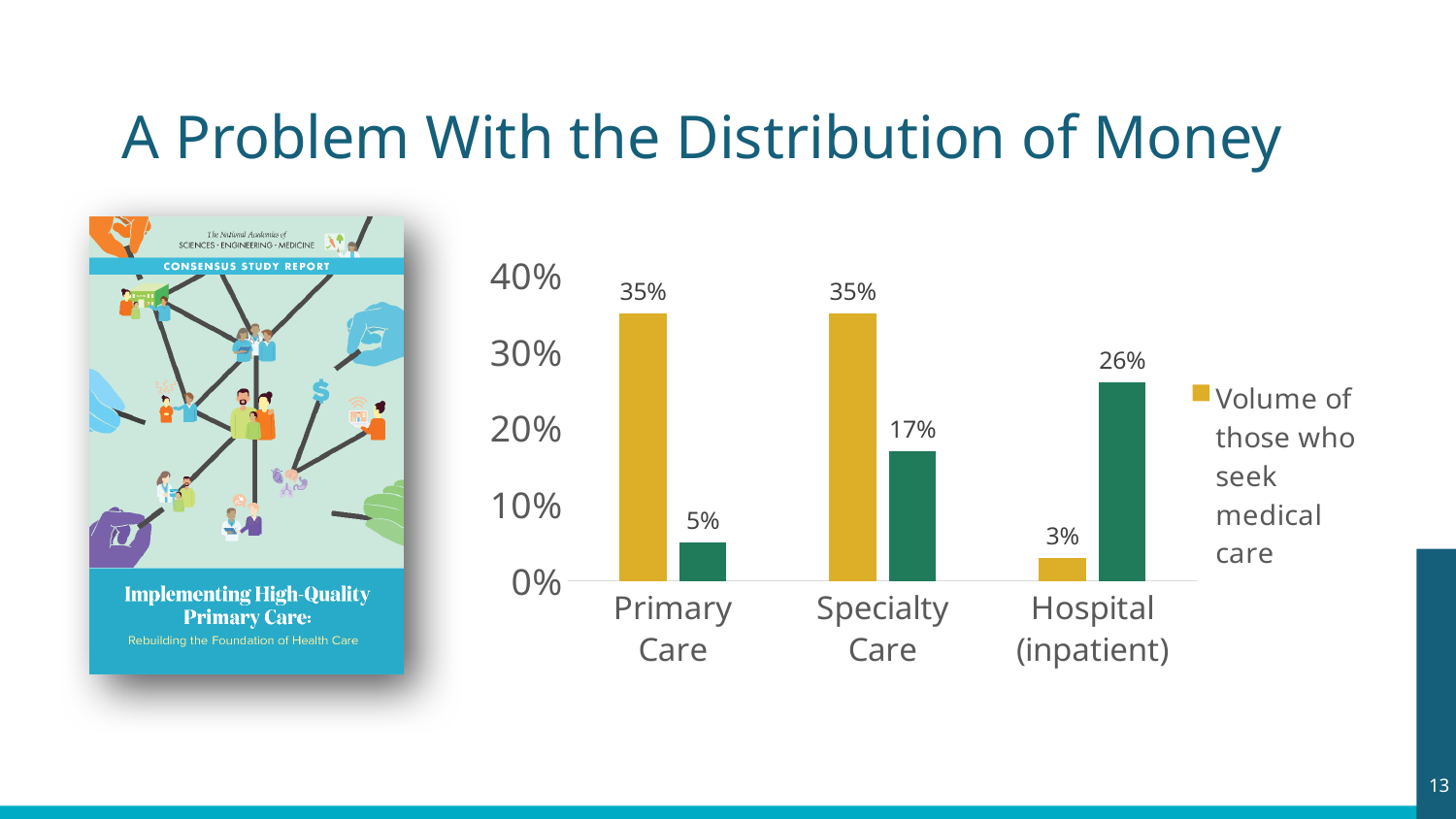
What is the difference between the green bars for Hospital (inpatient) and Specialty Care? 9% What is the value of 'Volume of those who seek medical care' for Hospital (inpatient)? 3% How many categories are shown on the x axis? 3 What is the value of the green bar for Specialty Care? 17% For Specialty Care, which is larger: the 'Volume of those who seek medical care' bar or the green bar? Volume of those who seek medical care What colour are the bars for 'Volume of those who seek medical care'? Yellow What kind of chart is shown on the slide? Bar chart Which category has the lowest value for 'Volume of those who seek medical care'? Hospital (inpatient) Which category has the highest green bar? Hospital (inpatient) What is the value of 'Volume of those who seek medical care' for Primary Care? 35% What is the value of the green bar for Hospital (inpatient)? 26% What is the difference between the yellow and green bars for Primary Care? 30%